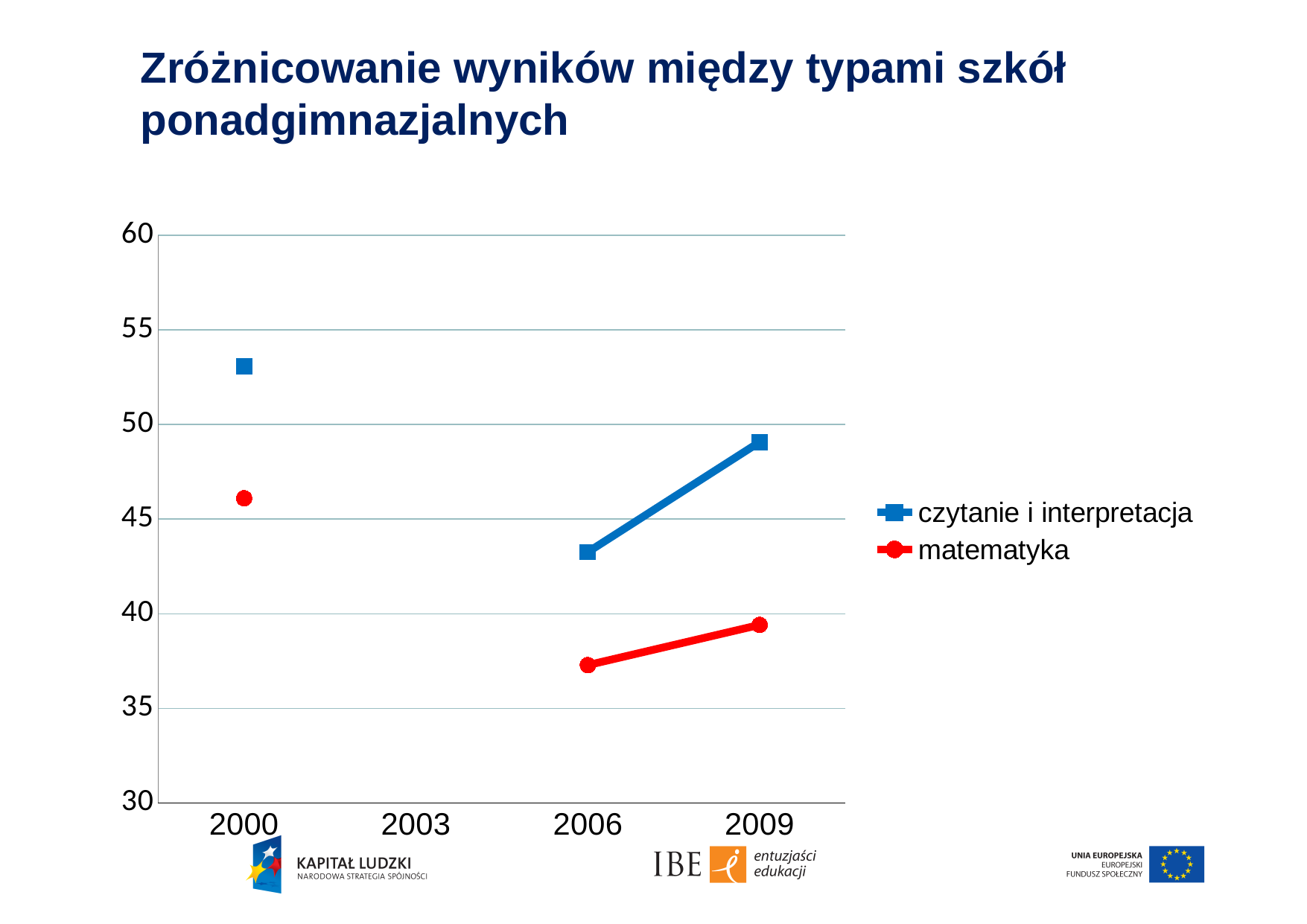
Between 2006 and 2009, does the value for matematyka rise or fall? rise How many series does the legend list? 2 Is the value for czytanie i interpretacja in 2006 greater or less than 45? less What kind of chart is shown on the slide? line chart In 2009, which series has the higher value, czytanie i interpretacja or matematyka? czytanie i interpretacja In which year does czytanie i interpretacja reach its highest value? 2000 Is the value for czytanie i interpretacja in 2000 greater or less than 50? greater How many years are labelled on the x axis? 4 Is the value for matematyka in 2000 greater or less than 45? greater Which series is shown in blue in the legend? czytanie i interpretacja Which series is shown in red in the legend? matematyka